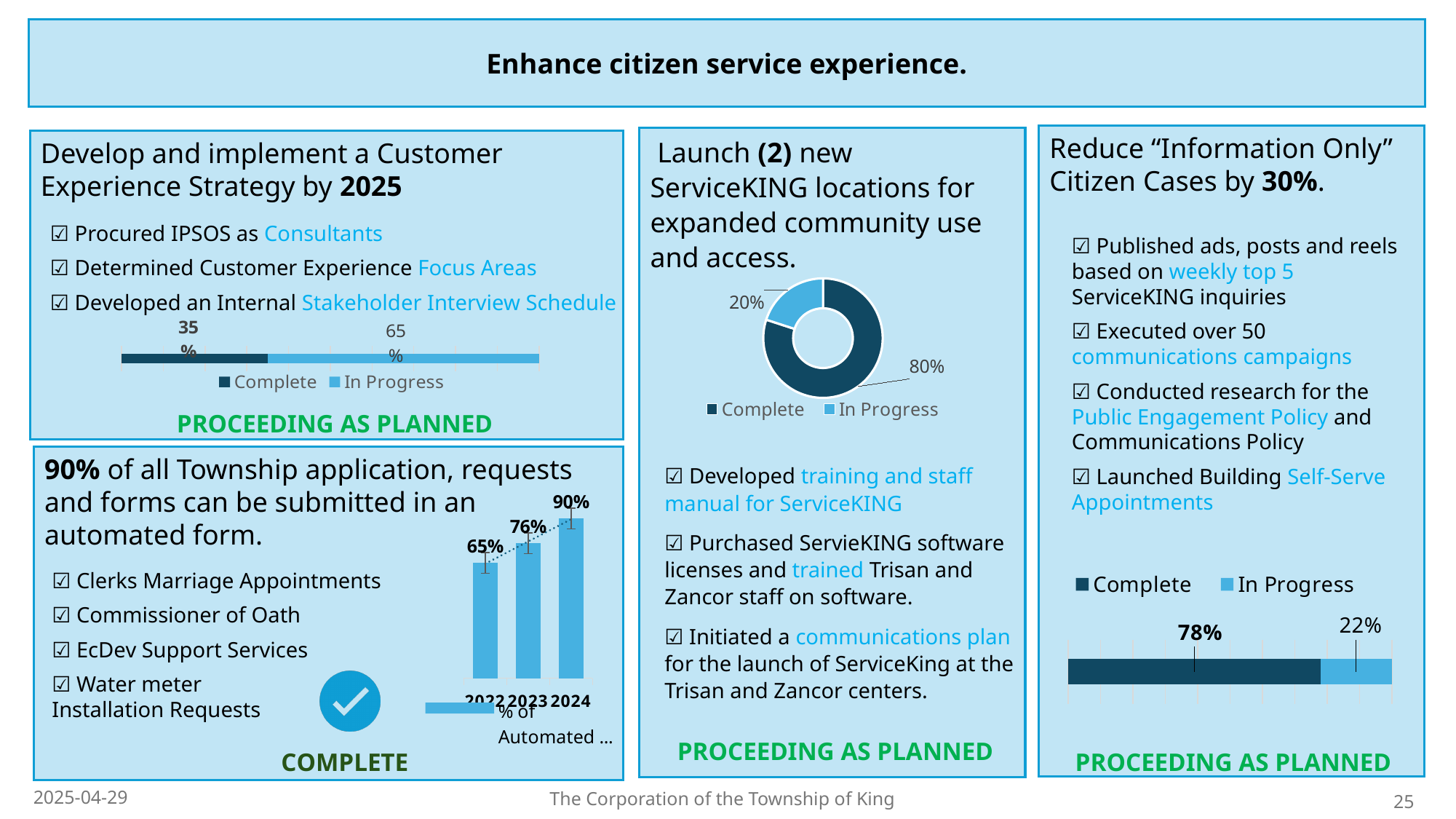
How many series does the legend list for the stacked bar chart in the right panel? 2 How many years are plotted in the bar chart in the bottom-left panel? 3 In the donut chart in the middle panel, what share is In Progress? 20% In the bar chart in the bottom-left panel, which year has the lowest value? 2022 In the bar chart in the bottom-left panel, do the values rise or fall from 2022 to 2024? rise In the bar chart in the bottom-left panel (90% of all Township application, requests and forms), what is the value for 2024? 90% In the bar chart in the bottom-left panel, what is the value for 2022? 65% In the stacked bar chart in the right panel (Reduce "Information Only" Citizen Cases by 30%), what is the Complete value? 78% In the donut chart in the middle panel (Launch (2) new ServiceKING locations), what share is Complete? 80% In the stacked bar chart in the top-left panel (Customer Experience Strategy by 2025), which is larger, Complete or In Progress? In Progress In the bar chart in the bottom-left panel, what is the difference between the 2024 and 2023 values? 14% What kind of chart is shown in the middle panel (Launch (2) new ServiceKING locations)? donut chart